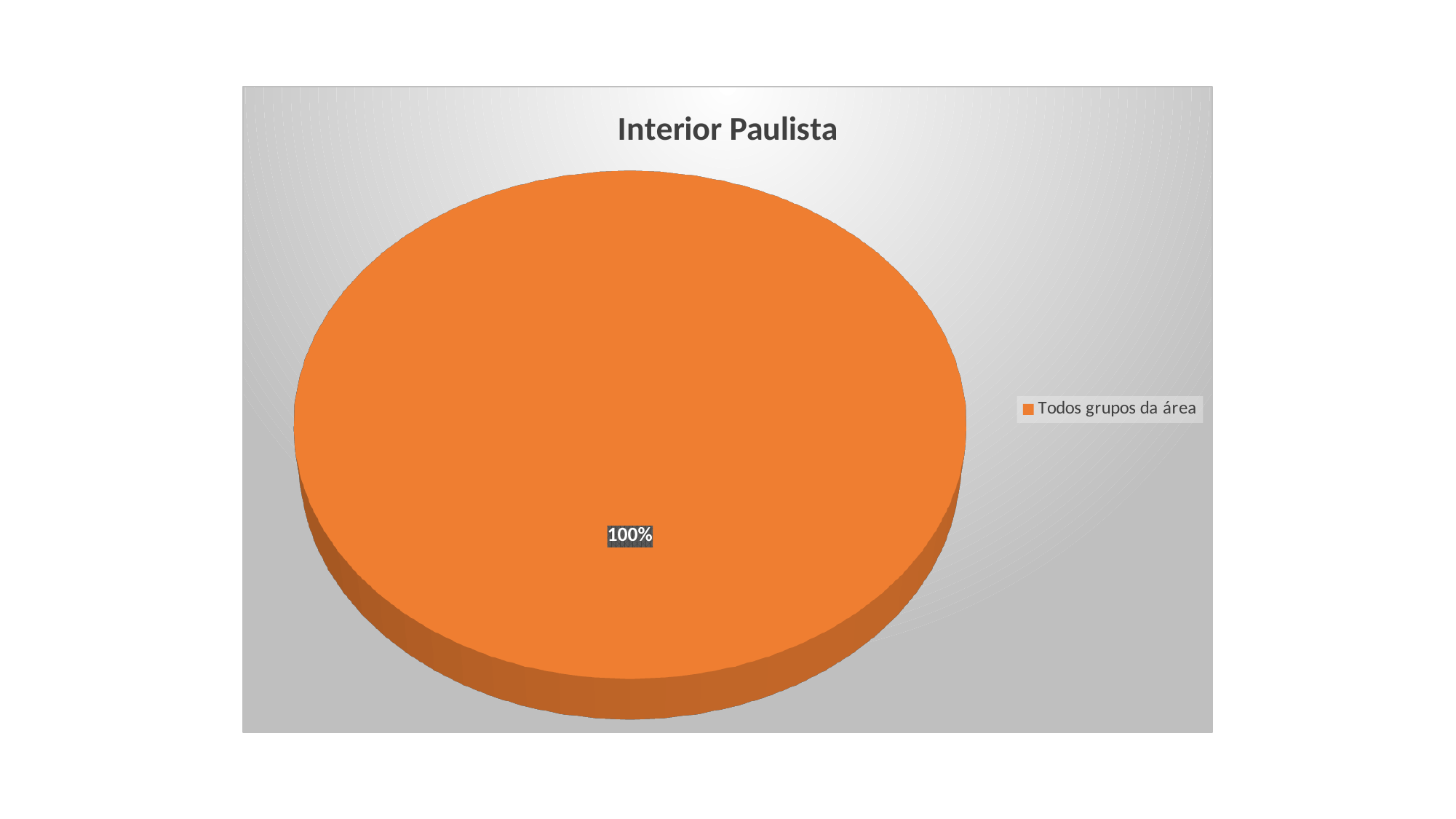
How many entries does the legend list? 1 How many slices does the pie chart have? 1 What is the data label shown on the pie slice? 100% What is the title of the chart? Interior Paulista What is the legend entry for the pie chart? Todos grupos da área What kind of chart is shown on the slide? pie chart What share of the pie does "Todos grupos da área" represent? 100%